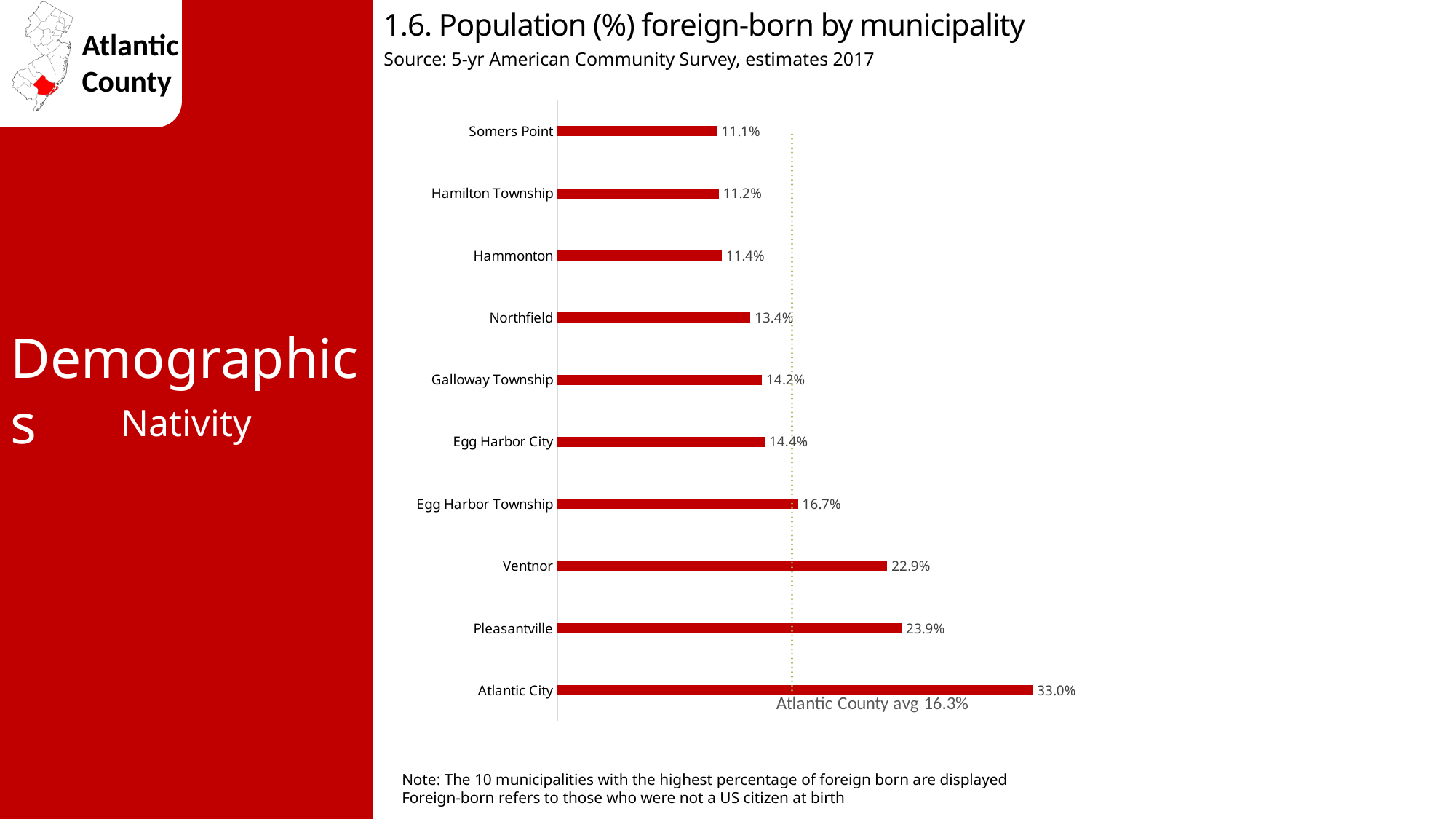
What kind of chart is shown on the slide? Bar chart What is the Atlantic County average foreign-born percentage marked on the chart? 16.3% What is the foreign-born percentage for Ventnor? 22.9% What is the difference between the foreign-born percentages of Atlantic City and Pleasantville? 9.1% Which municipality has the highest foreign-born percentage? Atlantic City Which has a higher foreign-born percentage, Egg Harbor Township or Northfield? Egg Harbor Township What is the source of the data shown in the chart? 5-yr American Community Survey, estimates 2017 What is the foreign-born percentage for Atlantic City? 33.0% How many municipalities are shown on the chart? 10 Which municipality has the lowest foreign-born percentage shown on the chart? Somers Point What is the difference between the foreign-born percentages of Hammonton and Somers Point? 0.3% What is the foreign-born percentage for Galloway Township? 14.2%